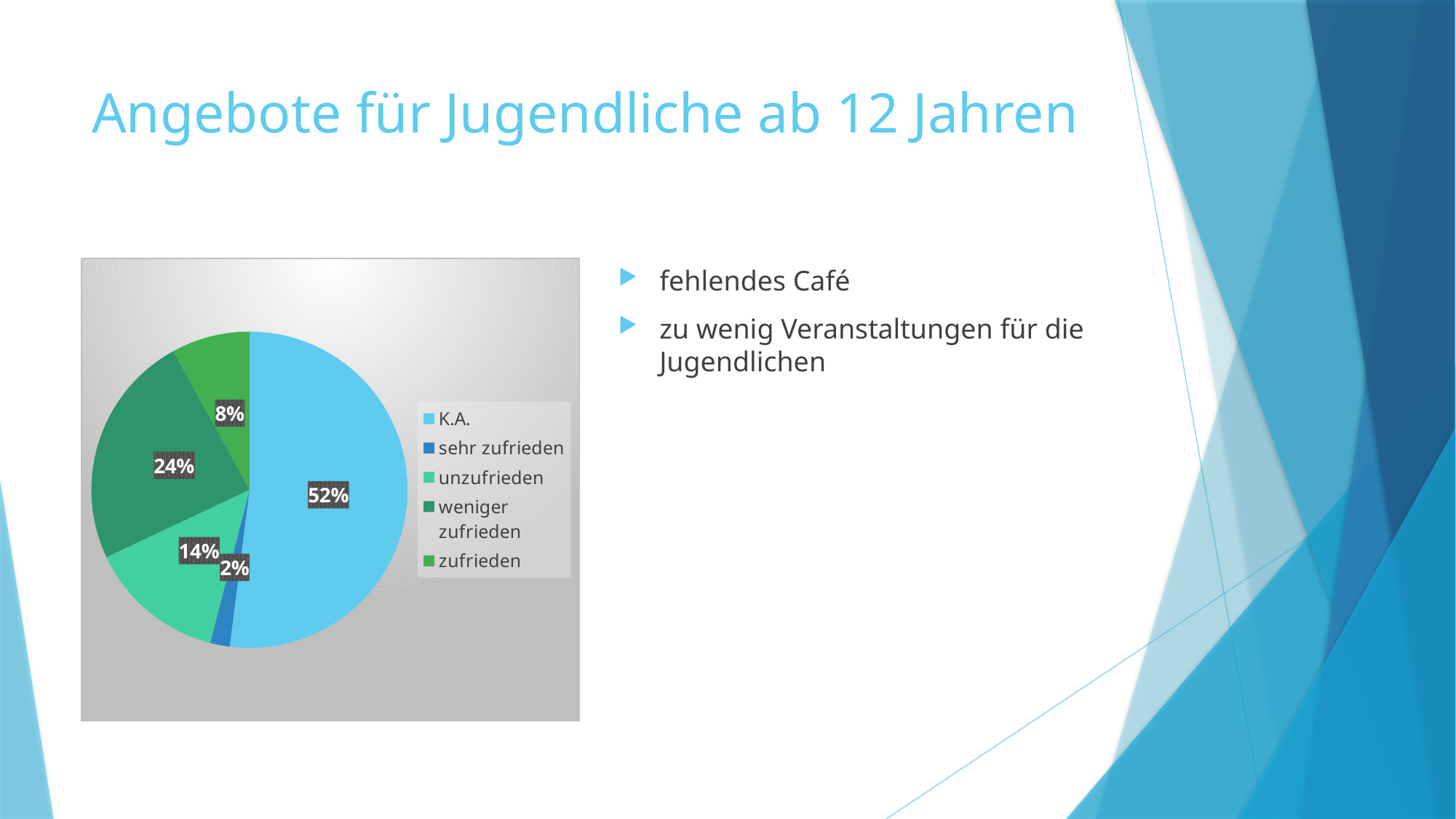
How many categories does the legend list? 5 What share of the pie does K.A. have? 52% Which is larger, the share for zufrieden or the share for unzufrieden? unzufrieden What is the difference between the shares of weniger zufrieden and unzufrieden? 10% What is the title of the slide containing the chart? Angebote für Jugendliche ab 12 Jahren What share of the pie does sehr zufrieden have? 2% What share of the pie does zufrieden have? 8% Which category has the largest slice of the pie? K.A. Which category has the smallest slice of the pie? sehr zufrieden What kind of chart is shown on the slide? pie chart